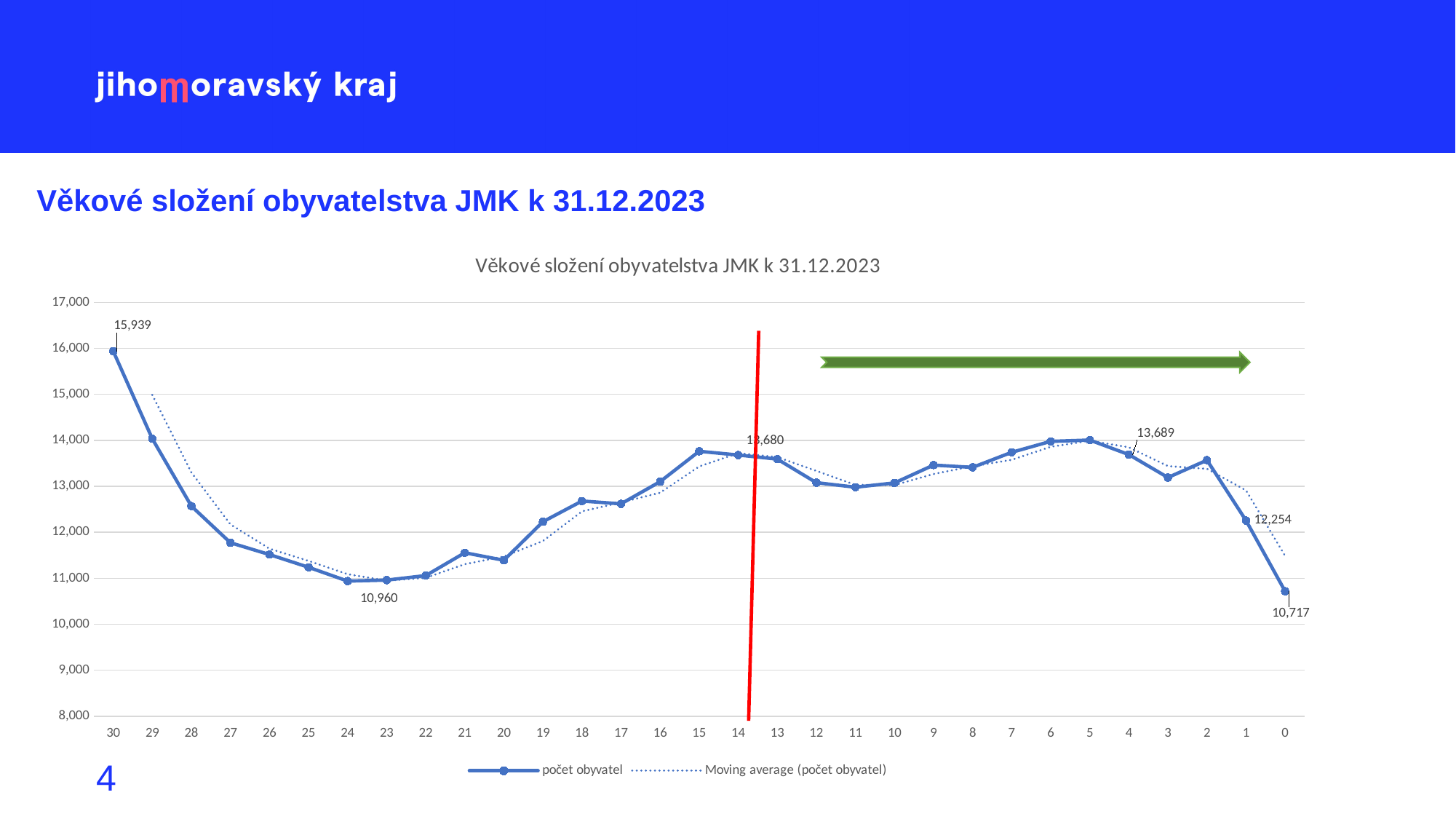
What kind of chart is shown on the slide? line chart What is the difference between the values for age 30 and age 0? 5,222 What is the value for age 4 in the chart? 13,689 What is the value for age 30 in the chart? 15,939 Which is larger, the value for age 4 or the value for age 1? age 4 Is the value for age 6 greater or less than 13,000? greater Which age category has the highest value in the chart? 30 How many series does the legend list? 2 What is the value for age 0 in the chart? 10,717 What is the value for age 1 in the chart? 12,254 Which age category has the lowest value in the chart? 0